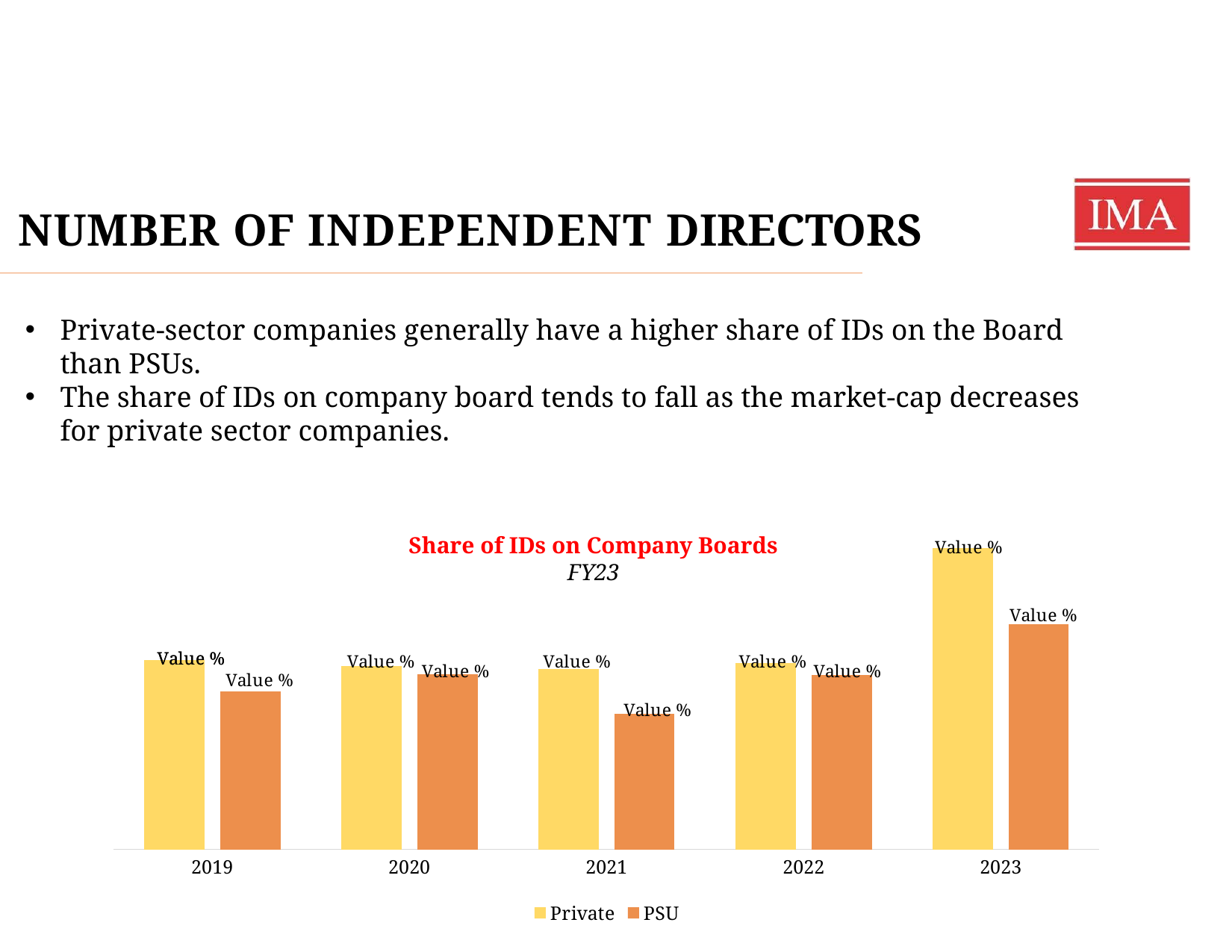
What are the two series named in the chart's legend? Private and PSU What kind of chart is shown on the slide? Bar chart How many series does the chart's legend list? 2 In 2021, which is larger, the Private bar or the PSU bar? Private Which is larger, the PSU bar for 2019 or the PSU bar for 2021? 2019 In which year is the Private bar the tallest? 2023 In which year is the PSU bar the shortest? 2021 In 2023, which is larger, the Private bar or the PSU bar? Private What is the title of the chart? Share of IDs on Company Boards In which year is the PSU bar the tallest? 2023 How many years are shown on the x axis of the chart? 5